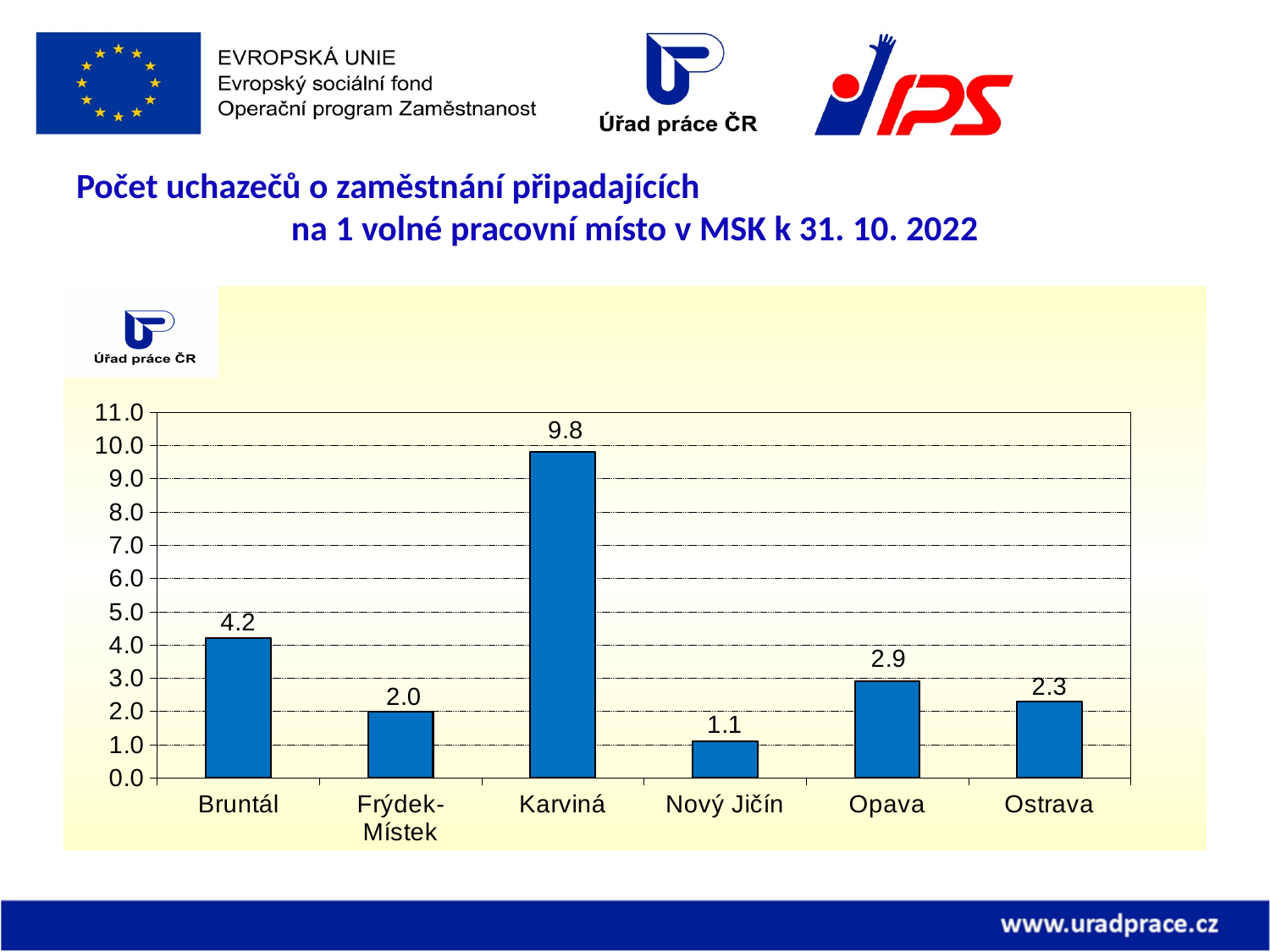
What is the title of the chart on the slide? Počet uchazečů o zaměstnání připadajících na 1 volné pracovní místo v MSK k 31. 10. 2022 What is the difference between the values for Karviná and Bruntál? 5.6 How many districts are shown on the chart? 6 Which is larger, the value for Frýdek-Místek or the value for Ostrava? Ostrava What is the value for Nový Jičín? 1.1 What kind of chart is shown on the slide? Bar chart Which district has the lowest value? Nový Jičín What is the difference between the values for Opava and Ostrava? 0.6 What is the value for Bruntál? 4.2 Which district has the highest value? Karviná What is the value for Opava? 2.9 What is the value for Karviná? 9.8